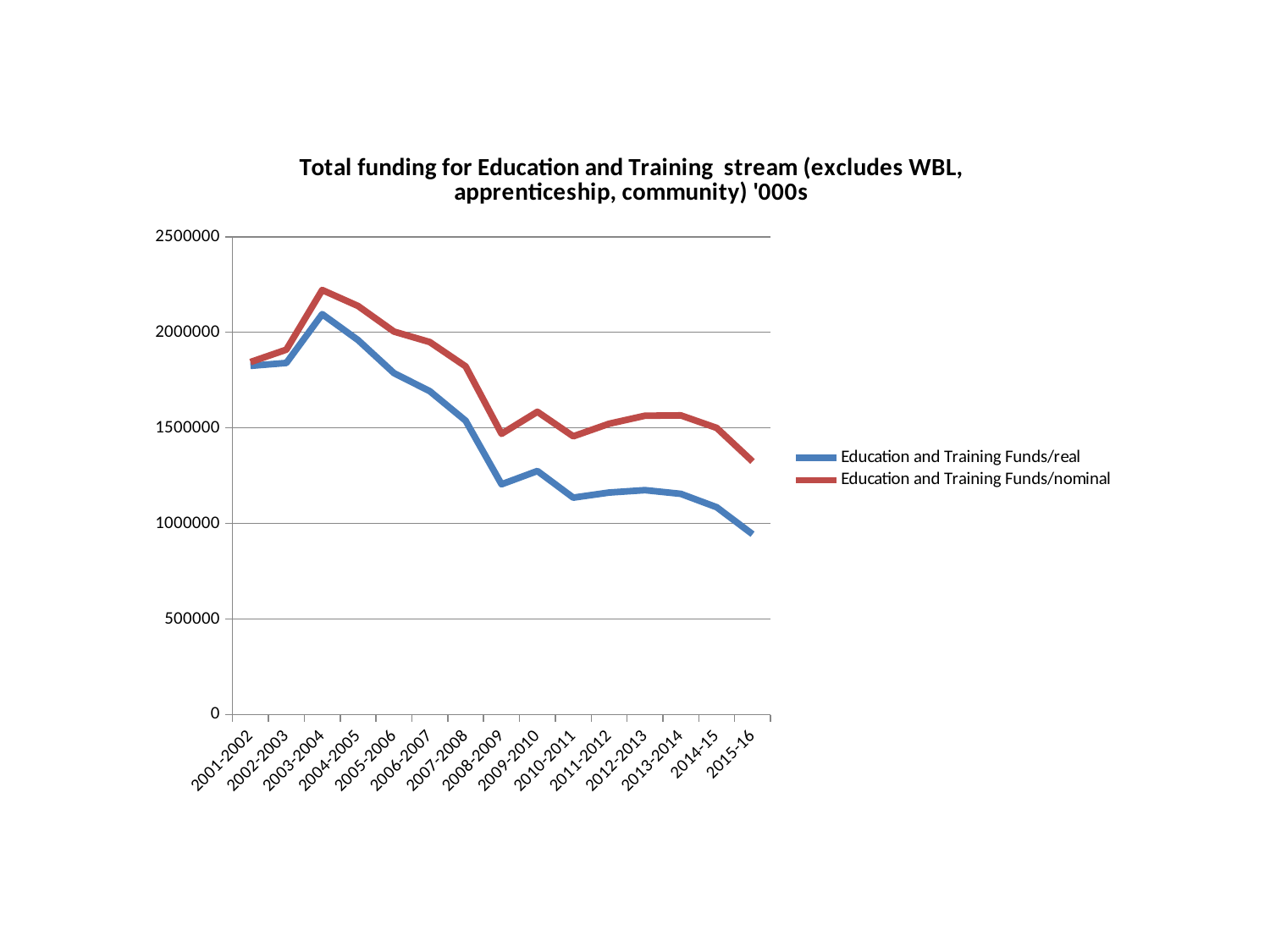
Is the value for Education and Training Funds/nominal in 2003-2004 greater or less than 2000000? greater What kind of chart is shown on the slide? line chart Is the value for Education and Training Funds/real in 2015-16 greater or less than 1000000? less How many time periods are plotted along the x axis? 15 From 2003-2004 to 2015-16, does the Education and Training Funds/real series generally rise or fall? fall In 2012-2013, which series has the larger value, Education and Training Funds/real or Education and Training Funds/nominal? Education and Training Funds/nominal In which period does the Education and Training Funds/nominal series reach its highest value? 2003-2004 In which period does the Education and Training Funds/real series reach its highest value? 2003-2004 Which colour is used for the Education and Training Funds/nominal series? red Is the value for Education and Training Funds/real in 2008-2009 greater or less than 1500000? less How many series does the legend list? 2 In which period is the Education and Training Funds/real series at its lowest? 2015-16